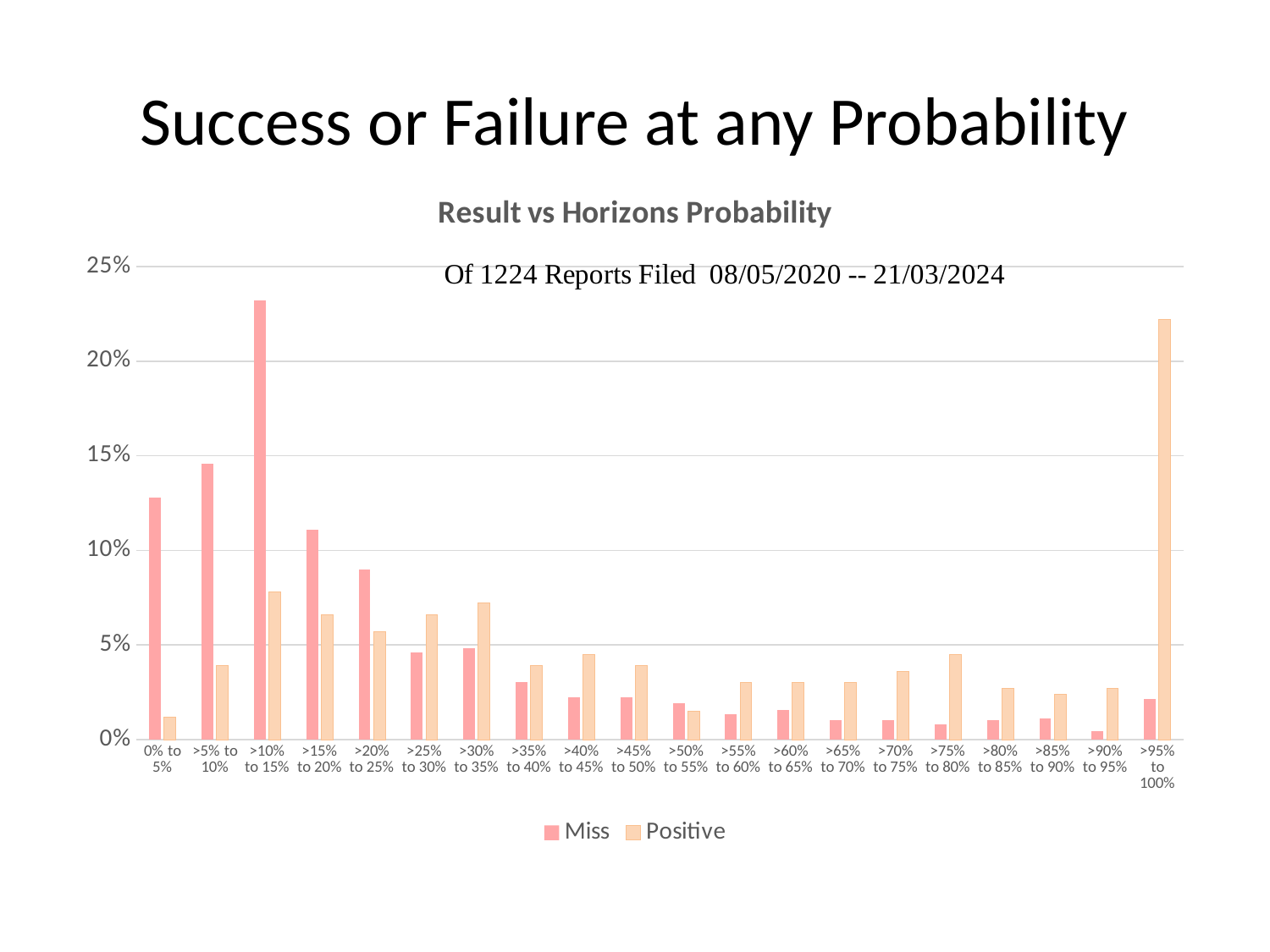
For the >95% to 100% category, which is larger, Miss or Positive? Positive Which category has the lowest Miss value? >90% to 95% What is the title of the chart? Result vs Horizons Probability Is the Positive value for >5% to 10% greater or less than 5%? less What kind of chart is shown on the slide? bar chart Which category has the highest Positive value? >95% to 100% Which category has the highest Miss value? >10% to 15% How many series does the legend list? 2 Is the Miss value for >10% to 15% greater or less than 20%? greater Is the Miss value for 0% to 5% greater or less than 10%? greater How many probability categories are shown on the x axis? 20 For the 0% to 5% category, which is larger, Miss or Positive? Miss